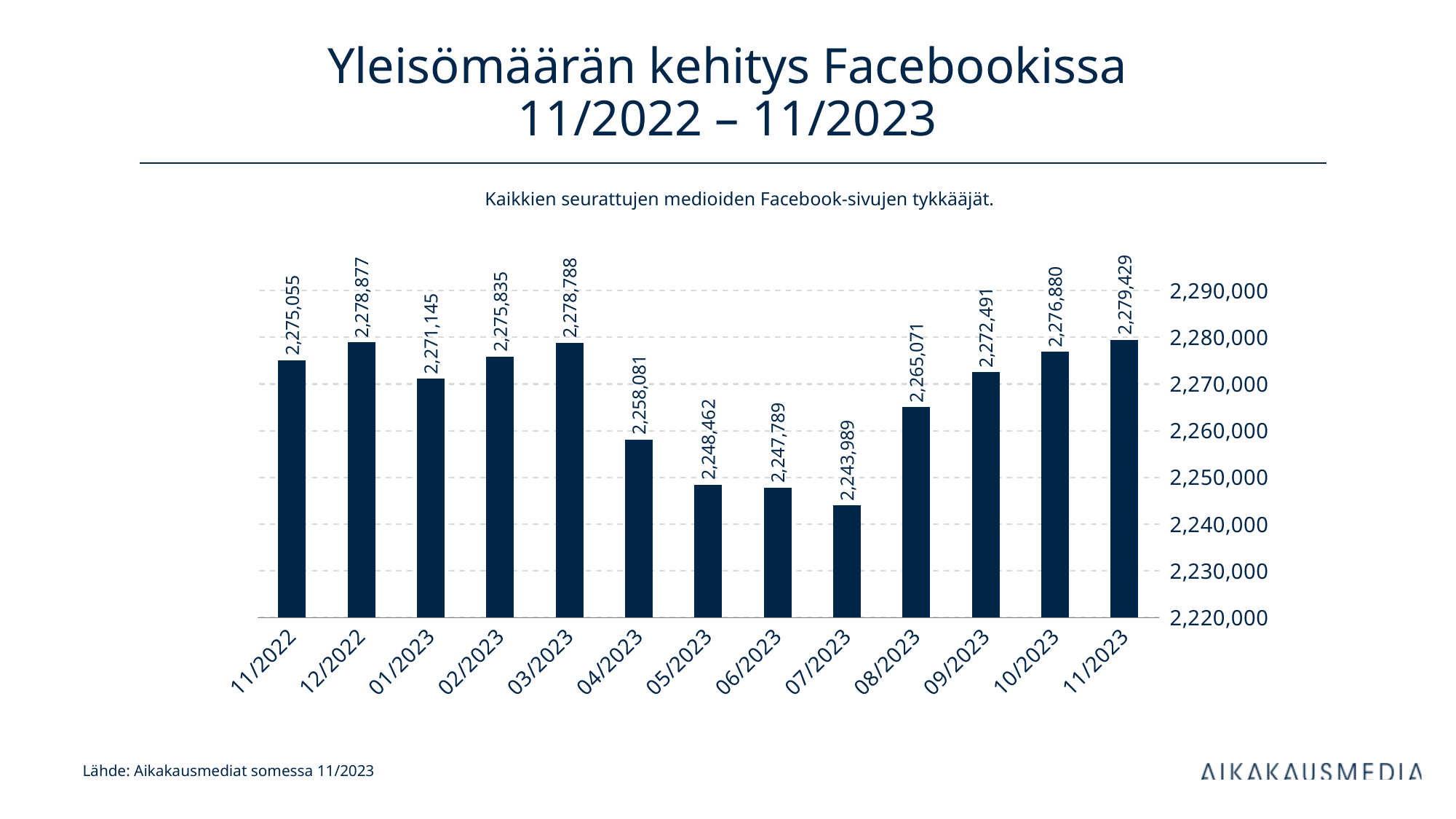
What is the value for 11/2022? 2,275,055 What kind of chart is shown on the slide? bar chart What is the value for 07/2023? 2,243,989 How many months are shown on the x axis? 13 Do the values rise or fall from 03/2023 to 07/2023? fall What is the difference between the values for 08/2023 and 07/2023? 21,082 Which is larger, the value for 12/2022 or the value for 01/2023? 12/2022 What is the value for 08/2023? 2,265,071 Is the value for 07/2023 greater or less than 2,250,000? less What is the difference between the values for 11/2023 and 11/2022? 4,374 Which month has the lowest value? 07/2023 Which month has the highest value? 11/2023